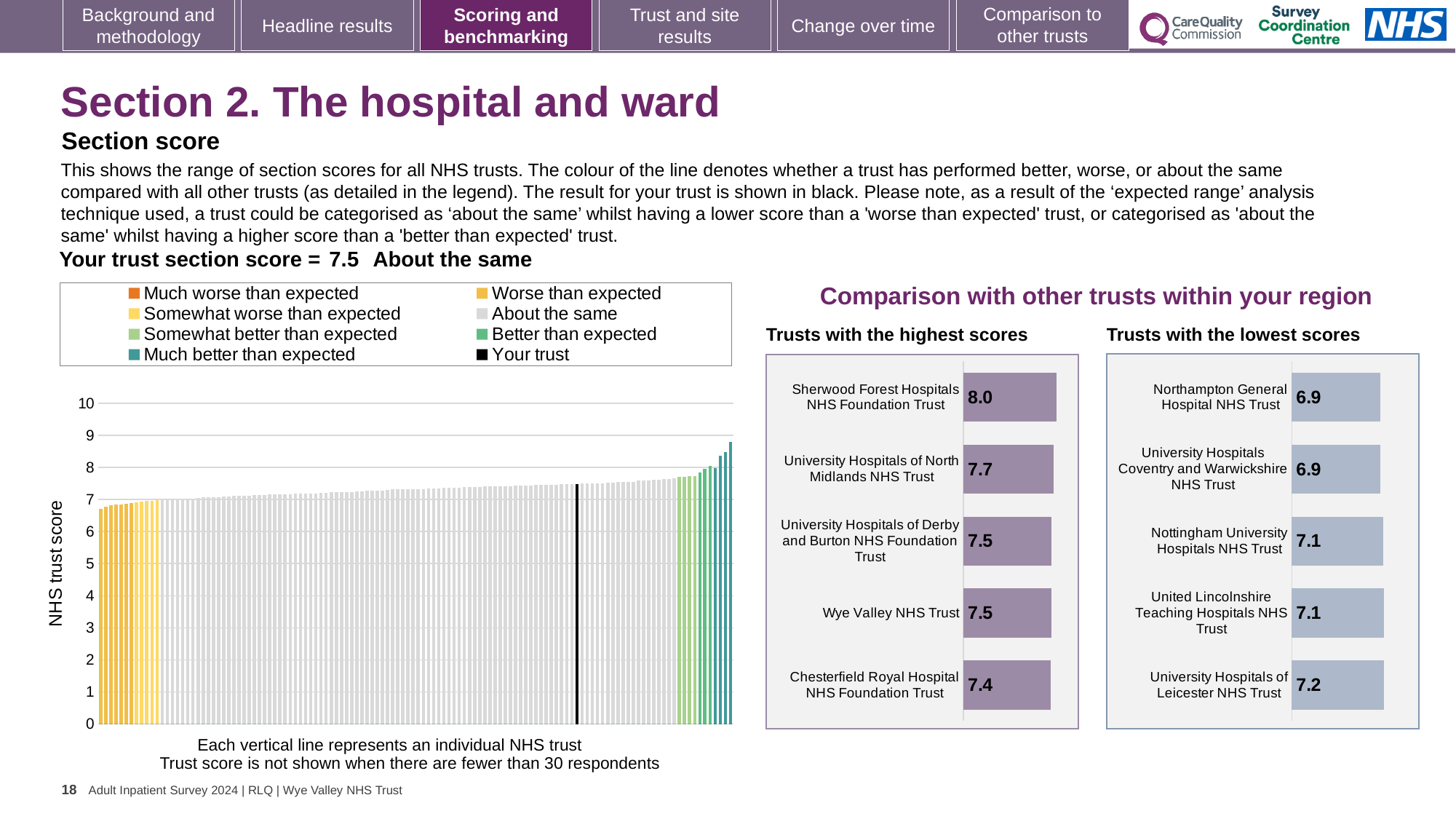
In the 'Trusts with the lowest scores' chart, what is the difference between the scores of University Hospitals of Leicester NHS Trust and Northampton General Hospital NHS Trust? 0.3 In the 'Trusts with the highest scores' chart, which has the higher score: University Hospitals of North Midlands NHS Trust or Wye Valley NHS Trust? University Hospitals of North Midlands NHS Trust In the 'Trusts with the highest scores' chart, what is the score for Sherwood Forest Hospitals NHS Foundation Trust? 8.0 In the large NHS trust score chart on the left, is the value for the black 'Your trust' bar greater or less than 7? greater In the 'Trusts with the highest scores' chart, which trust has the lowest score? Chesterfield Royal Hospital NHS Foundation Trust In the large NHS trust score chart on the left, how many entries does the legend list? 8 In the 'Trusts with the highest scores' chart, what is the difference between the scores of Sherwood Forest Hospitals NHS Foundation Trust and Chesterfield Royal Hospital NHS Foundation Trust? 0.6 In the 'Trusts with the lowest scores' chart, what is the score for Nottingham University Hospitals NHS Trust? 7.1 In the 'Trusts with the lowest scores' chart, which trust has the highest score? University Hospitals of Leicester NHS Trust In the 'Trusts with the highest scores' chart, how many trusts are shown? 5 What kind of chart is the large NHS trust score chart on the left? Bar chart In the 'Trusts with the lowest scores' chart, what is the score for University Hospitals Coventry and Warwickshire NHS Trust? 6.9